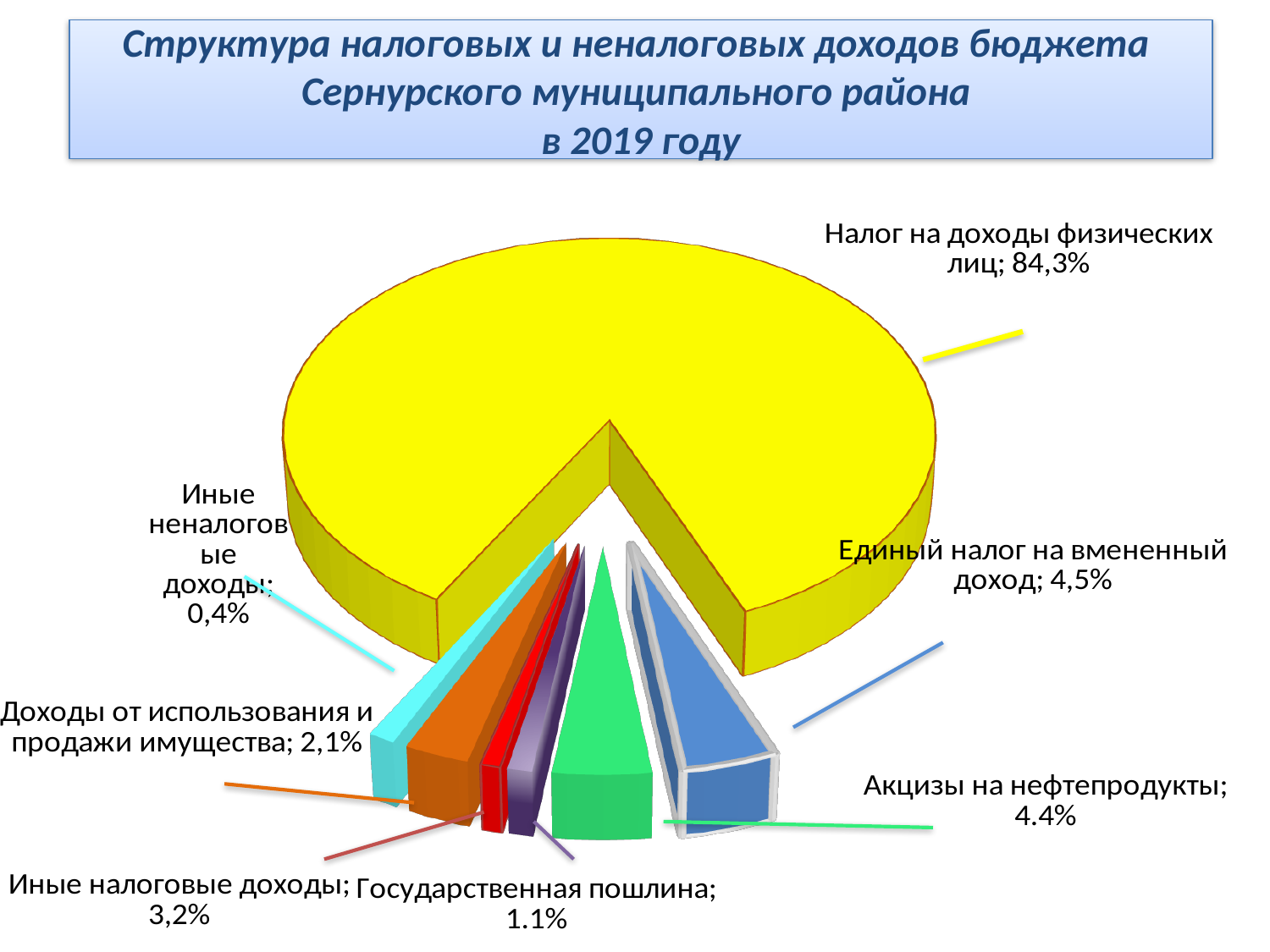
Which category has the smallest share of the pie? Иные неналоговые доходы What value is shown for Иные налоговые доходы? 3,2% What is the difference between the shares for Единый налог на вмененный доход and Иные налоговые доходы? 1,3% What value is shown for Акцизы на нефтепродукты? 4.4% How many slices does the pie chart have? 7 What value is shown for Доходы от использования и продажи имущества? 2,1% Which is larger, the share for Иные налоговые доходы or the share for Доходы от использования и продажи имущества? Иные налоговые доходы What value is shown for Единый налог на вмененный доход? 4,5% What value is shown for Государственная пошлина? 1.1% What share of the pie is labelled for Налог на доходы физических лиц? 84,3% Which category has the largest share of the pie? Налог на доходы физических лиц What kind of chart is shown on the slide? pie chart